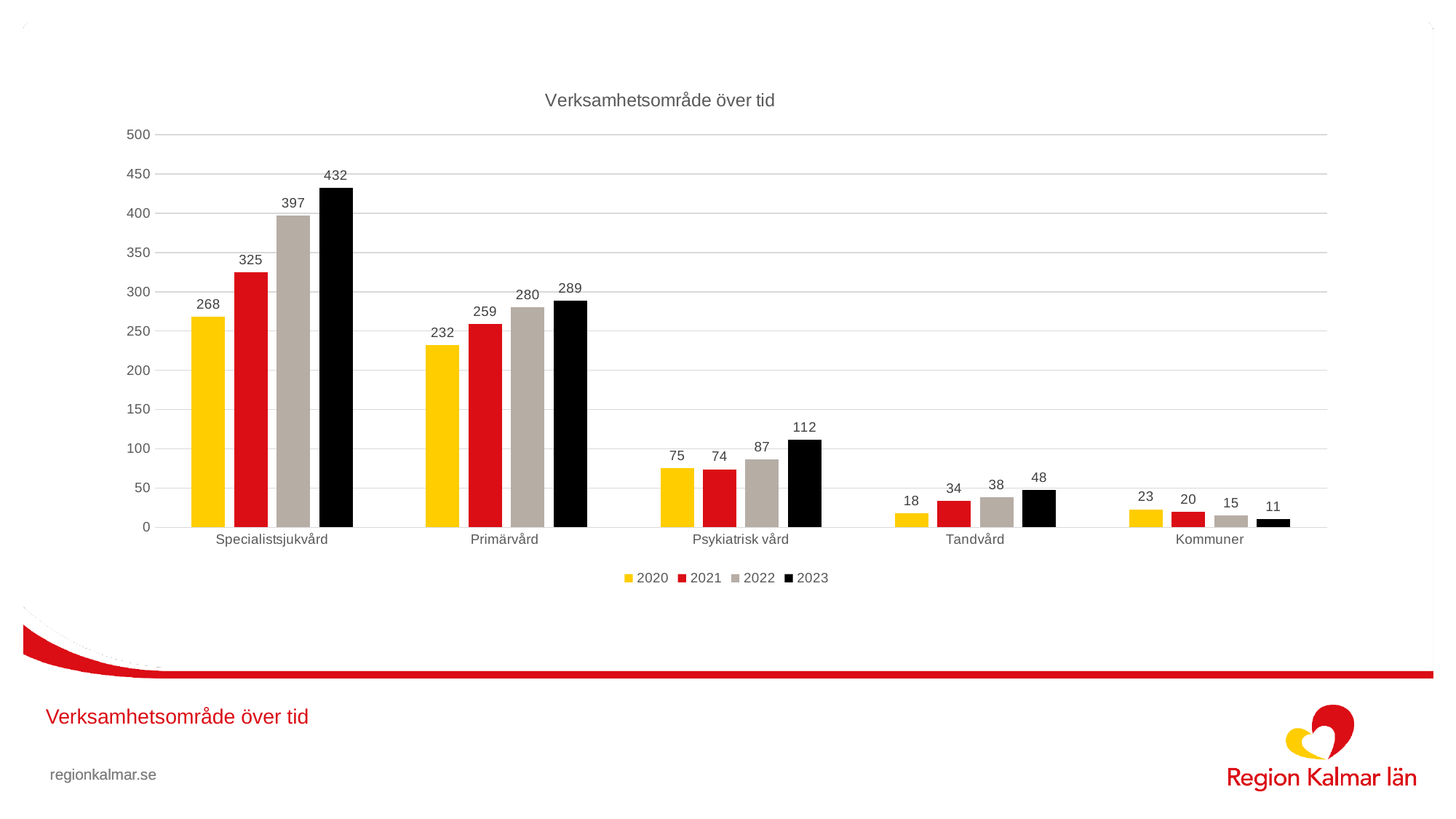
What is the difference between the 2023 and 2020 values for Psykiatrisk vård? 37 What is the value for Primärvård in 2020? 232 What is the value for Kommuner in 2022? 15 Which category has the highest value in 2021? Specialistsjukvård How many series does the legend list? 4 What is the title of the chart? Verksamhetsområde över tid How many categories are shown on the x axis? 5 Which category has the lowest value in 2023? Kommuner What is the value for Specialistsjukvård in 2023? 432 Which is larger for Tandvård: the 2021 value or the 2022 value? 2022 What kind of chart is shown on the slide? Bar chart Do the values for Kommuner rise or fall from 2020 to 2023? Fall